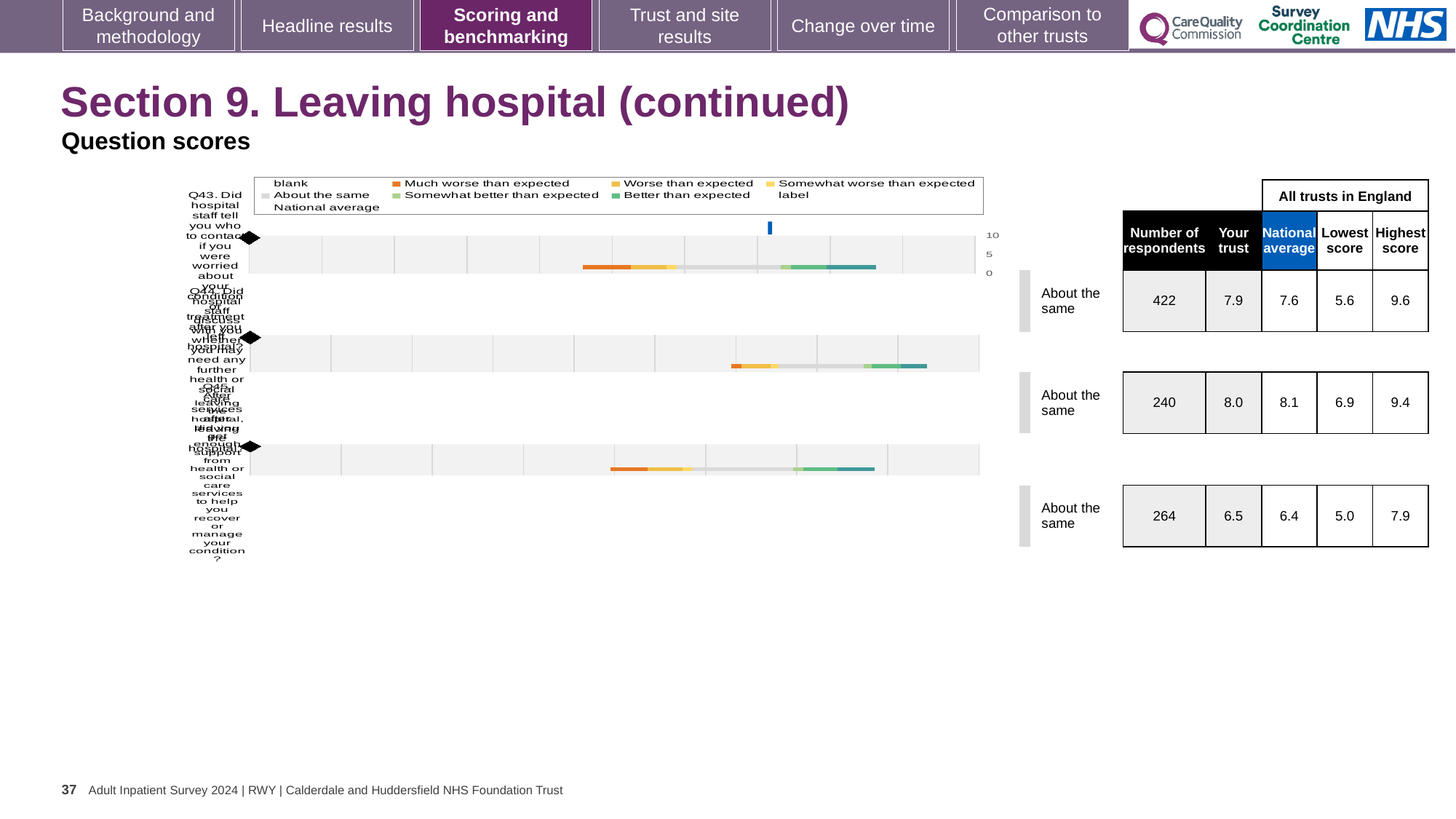
What is the highest value shown on the axis above the first chart row? 10 How many question rows (charts) are shown on the slide? 3 For the first (top) question row, what is the difference between the highest score and the lowest score? 4.0 In the table beside the charts, what is the national average for the first (top) question row? 7.6 In the table beside the charts, what is the number of respondents for the first (top) question row? 422 Which question row has the highest 'Your trust' score? the second row (8.0) In the table beside the charts, what is the 'Your trust' score for the first (top) question row? 7.9 What benchmark category label is shown next to each of the three chart rows? About the same What kind of chart is used to show the question scores on this slide? bar chart For the first (top) question row, which is larger: the 'Your trust' score or the national average? Your trust Which question row has the lowest number of respondents? the second row (240) In the table beside the charts, what is the 'Your trust' score for the second question row? 8.0